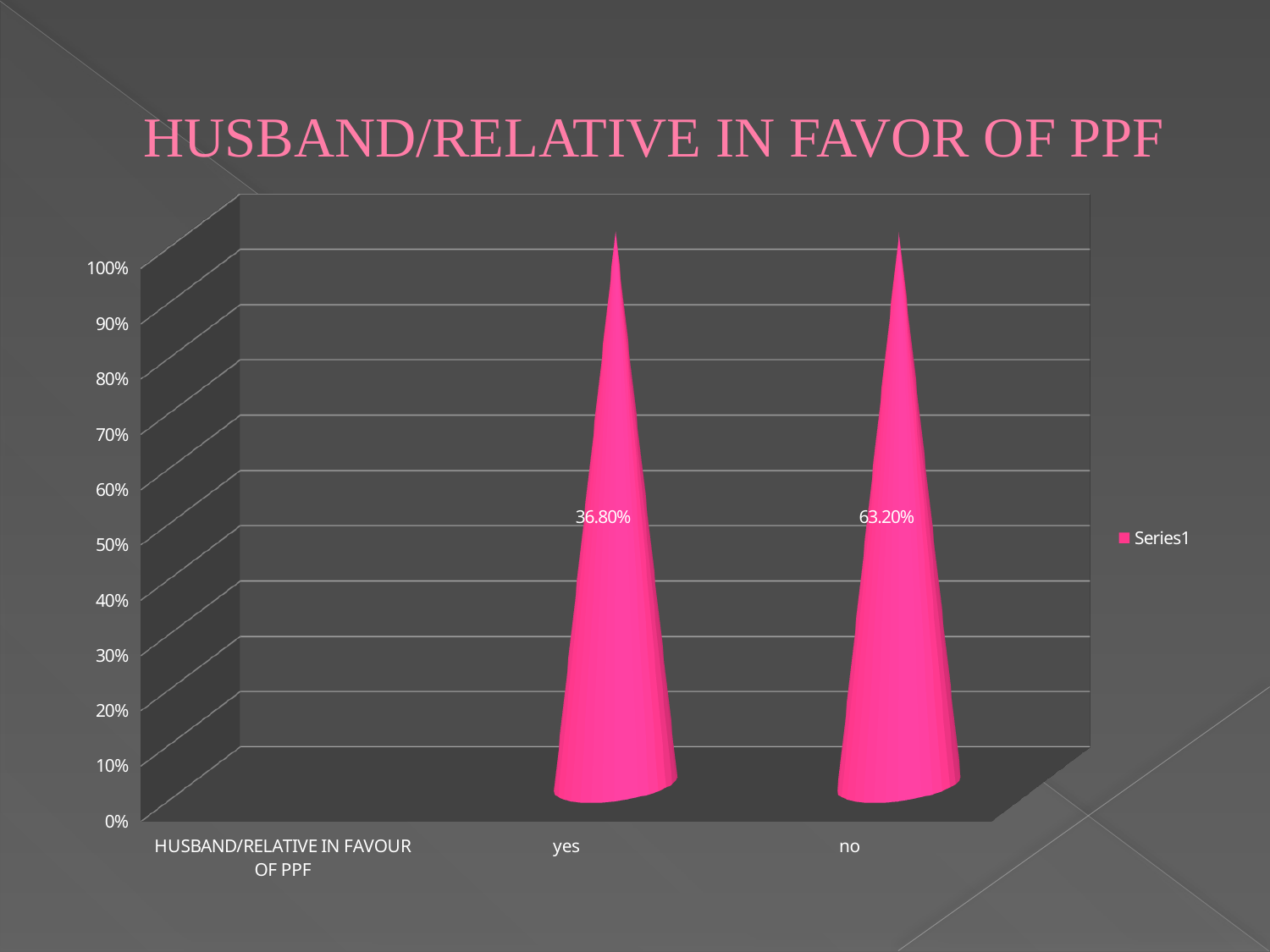
What is the highest value shown on the vertical axis? 100% What kind of chart is shown on the slide? bar chart What is the difference between the values for "no" and "yes"? 26.40% How many series does the legend list? 1 What is the value for "yes"? 36.80% Which category has the highest labelled value? no Which category has the lowest labelled value? yes How many bars are plotted in the chart? 2 What is the title of the chart? HUSBAND/RELATIVE IN FAVOR OF PPF What is the value for "no"? 63.20% Which category has the higher value according to the data labels, "yes" or "no"? no What is the name of the series shown in the legend? Series1